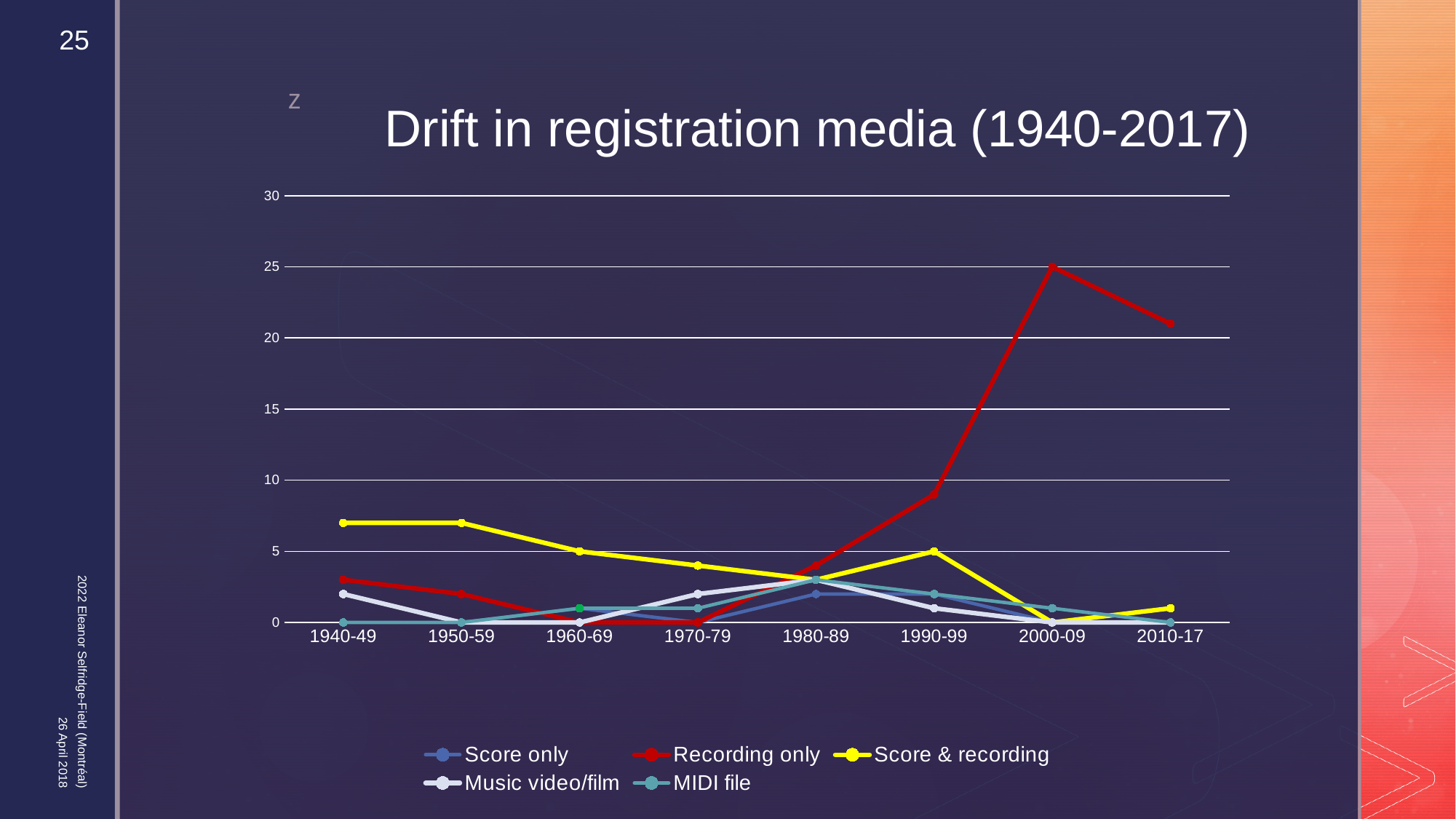
What is the value for Score & recording in 2000-09? 0 Which series is drawn in yellow? Score & recording Which series has the higher value in 2000-09, Recording only or Score & recording? Recording only How many time periods are shown on the x axis? 8 Is the value for Recording only in 2010-17 greater or less than 20? greater What is the value for Score & recording in 1960-69? 5 In which period does Recording only reach its highest value? 2000-09 What is the value for Recording only in 2000-09? 25 What is the title of the chart? Drift in registration media (1940-2017) What kind of chart is shown on the slide? line chart Is the value for Score & recording in 1940-49 greater or less than 5? greater How many series does the legend list? 5